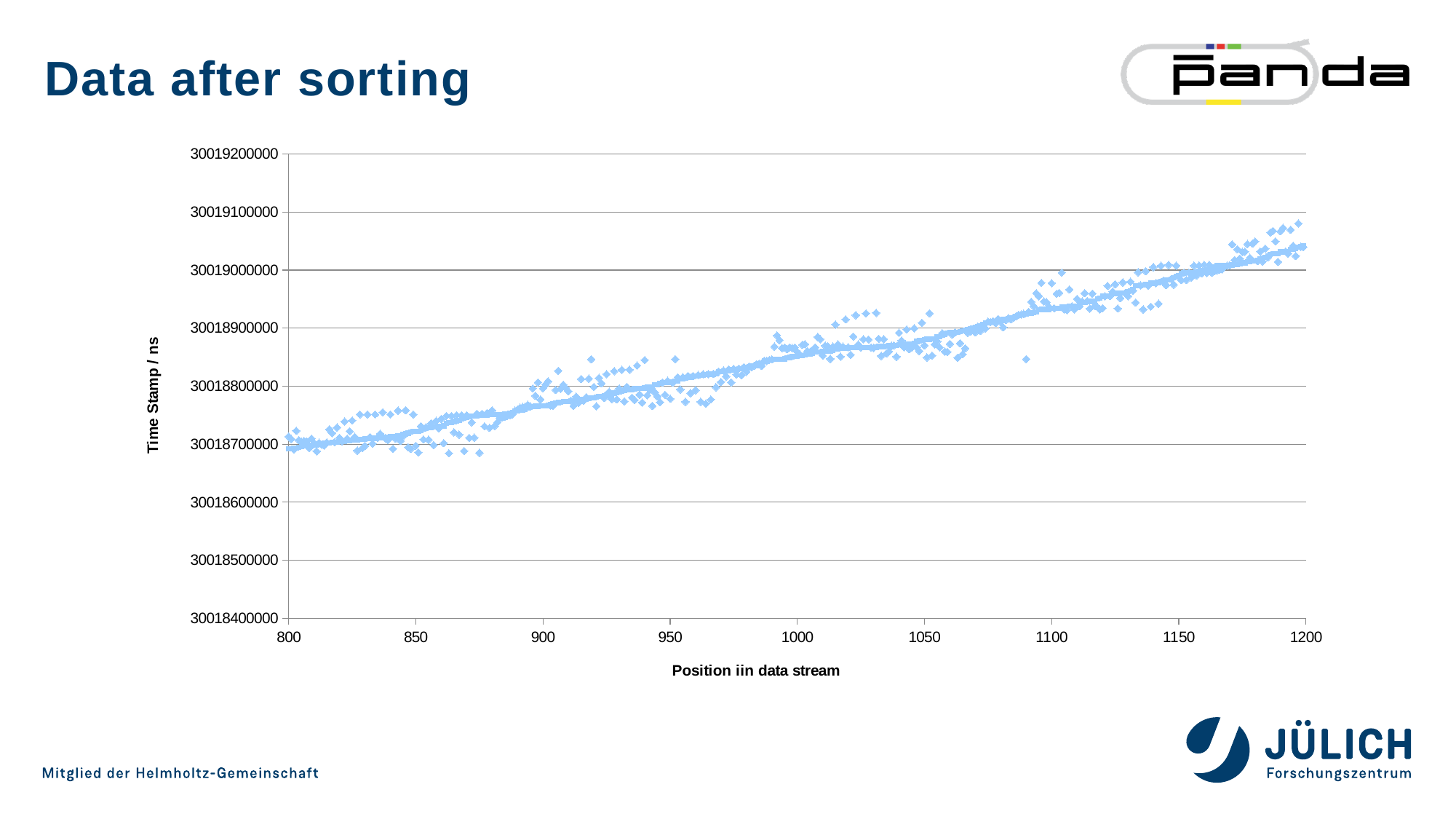
What is the label of the y axis? Time Stamp / ns Is the time stamp value at position 1000 greater or less than 30018900000? less Is the time stamp value at position 1200 greater or less than 30019000000? greater Is the time stamp value at position 800 greater or less than 30018800000? less Do the time stamp values rise or fall as the position in the data stream increases from 800 to 1200? rise Which has the lower time stamp values: position 900 or position 1100? position 900 What kind of chart is shown on the slide? scatter chart Which has the higher time stamp values: position 800 or position 1200? position 1200 What is the label of the x axis? Position iin data stream